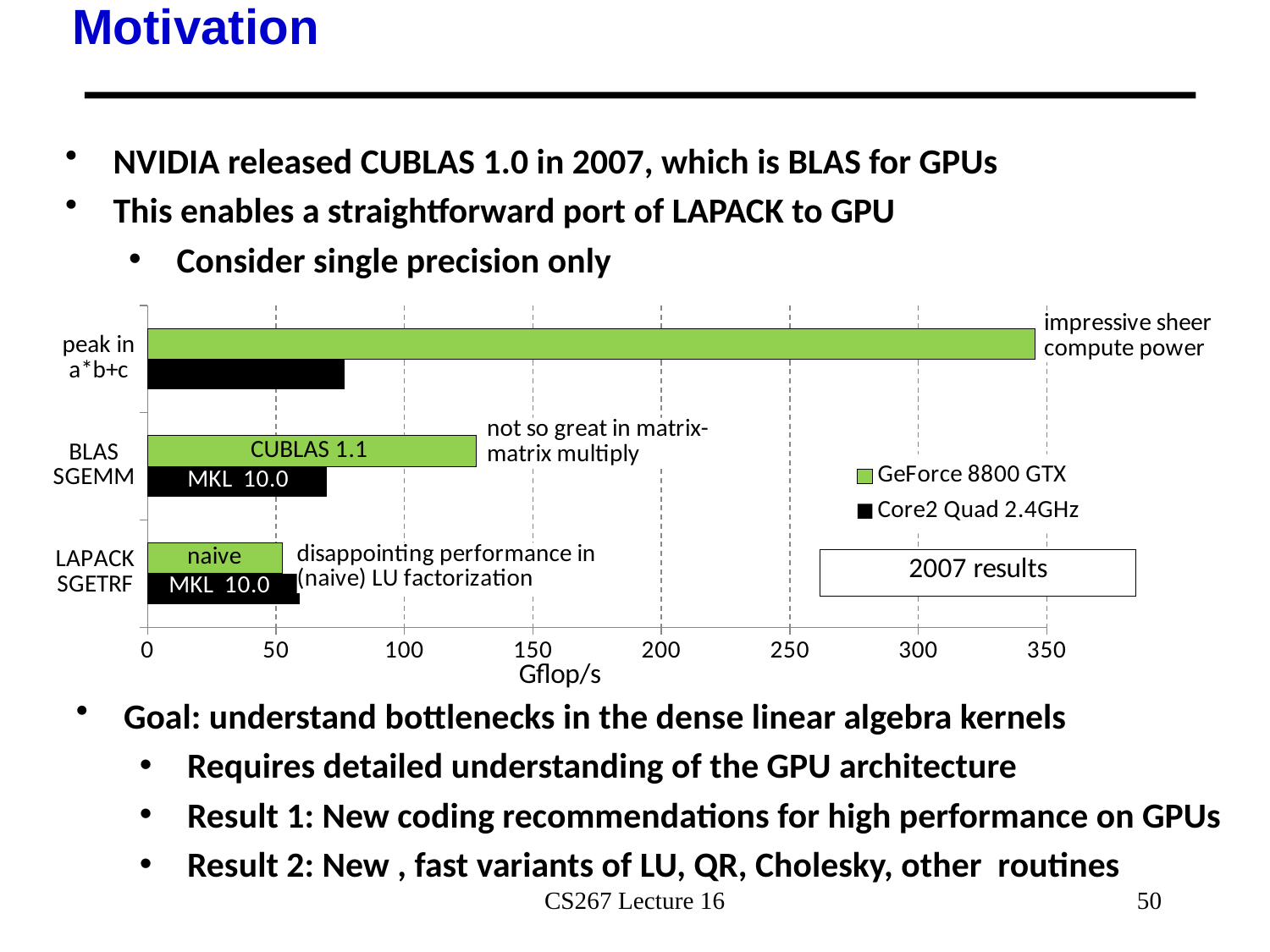
How many series does the chart's legend list? 2 Is the Core2 Quad 2.4GHz value for peak in a*b+c greater or less than 100? less Is the GeForce 8800 GTX value for BLAS SGEMM greater or less than 100? greater What are the two series named in the chart's legend? GeForce 8800 GTX and Core2 Quad 2.4GHz How many categories are shown on the chart's vertical axis? 3 Which category has the highest GeForce 8800 GTX value? peak in a*b+c For BLAS SGEMM, which series has the larger value, GeForce 8800 GTX or Core2 Quad 2.4GHz? GeForce 8800 GTX For peak in a*b+c, which series has the larger value, GeForce 8800 GTX or Core2 Quad 2.4GHz? GeForce 8800 GTX What kind of chart is shown on the slide? bar chart What is the label on the chart's horizontal axis? Gflop/s Which category has the lowest GeForce 8800 GTX value? LAPACK SGETRF Is the GeForce 8800 GTX value for peak in a*b+c greater or less than 300? greater